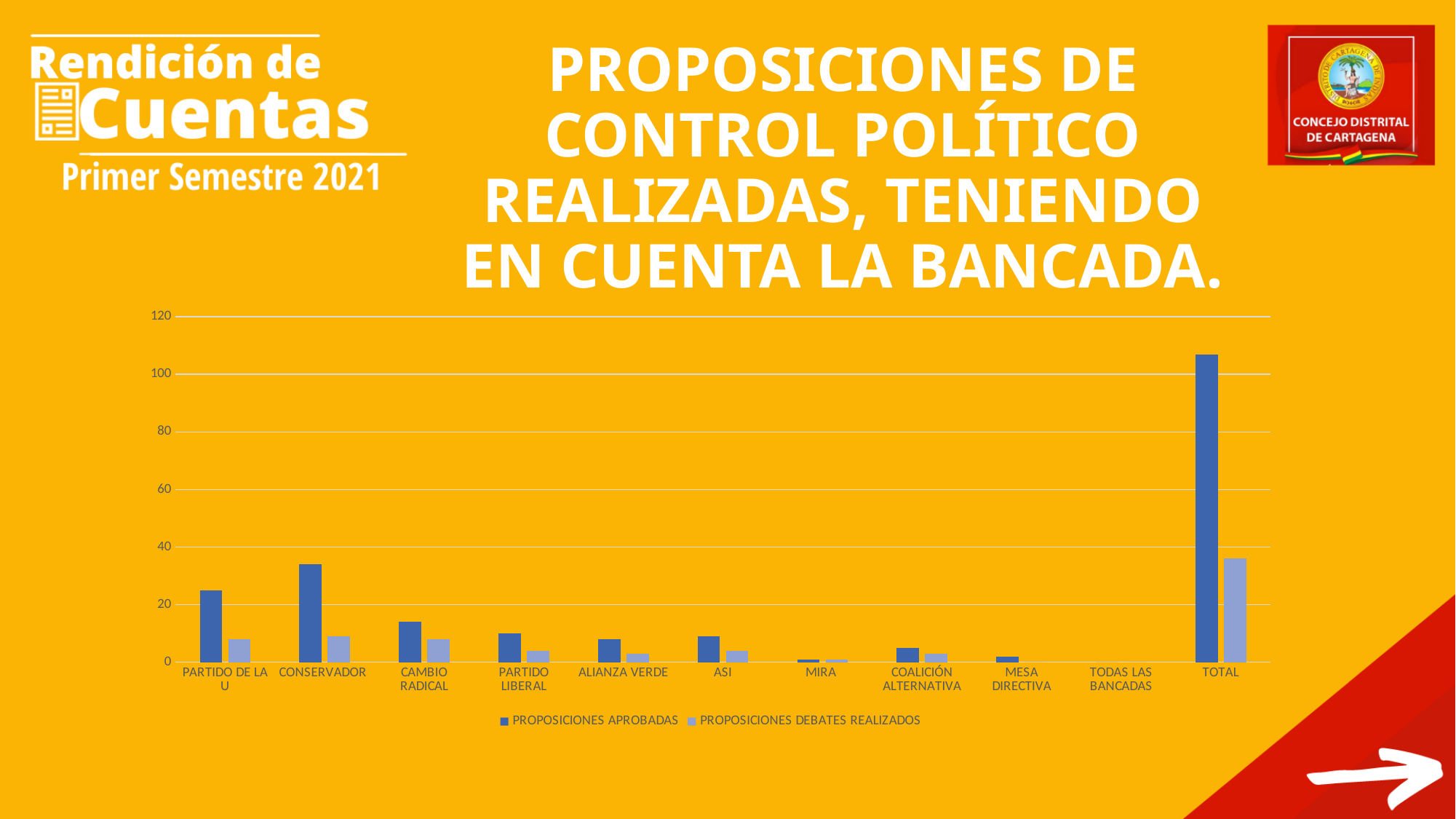
What are the two series named in the chart's legend? PROPOSICIONES APROBADAS and PROPOSICIONES DEBATES REALIZADOS How many categories are shown along the x axis of the chart? 11 How many series does the chart's legend list? 2 Is the PROPOSICIONES APROBADAS value for TOTAL greater or less than 100? greater For CONSERVADOR, which series has the larger value: PROPOSICIONES APROBADAS or PROPOSICIONES DEBATES REALIZADOS? PROPOSICIONES APROBADAS What kind of chart is shown on the slide? bar chart Which category has the highest value for PROPOSICIONES APROBADAS? TOTAL Is the PROPOSICIONES DEBATES REALIZADOS value for TOTAL greater or less than 60? less Which is larger for PROPOSICIONES APROBADAS: CONSERVADOR or PARTIDO DE LA U? CONSERVADOR Excluding TOTAL, which category has the highest value for PROPOSICIONES APROBADAS? CONSERVADOR Is the PROPOSICIONES APROBADAS value for CAMBIO RADICAL greater or less than 20? less